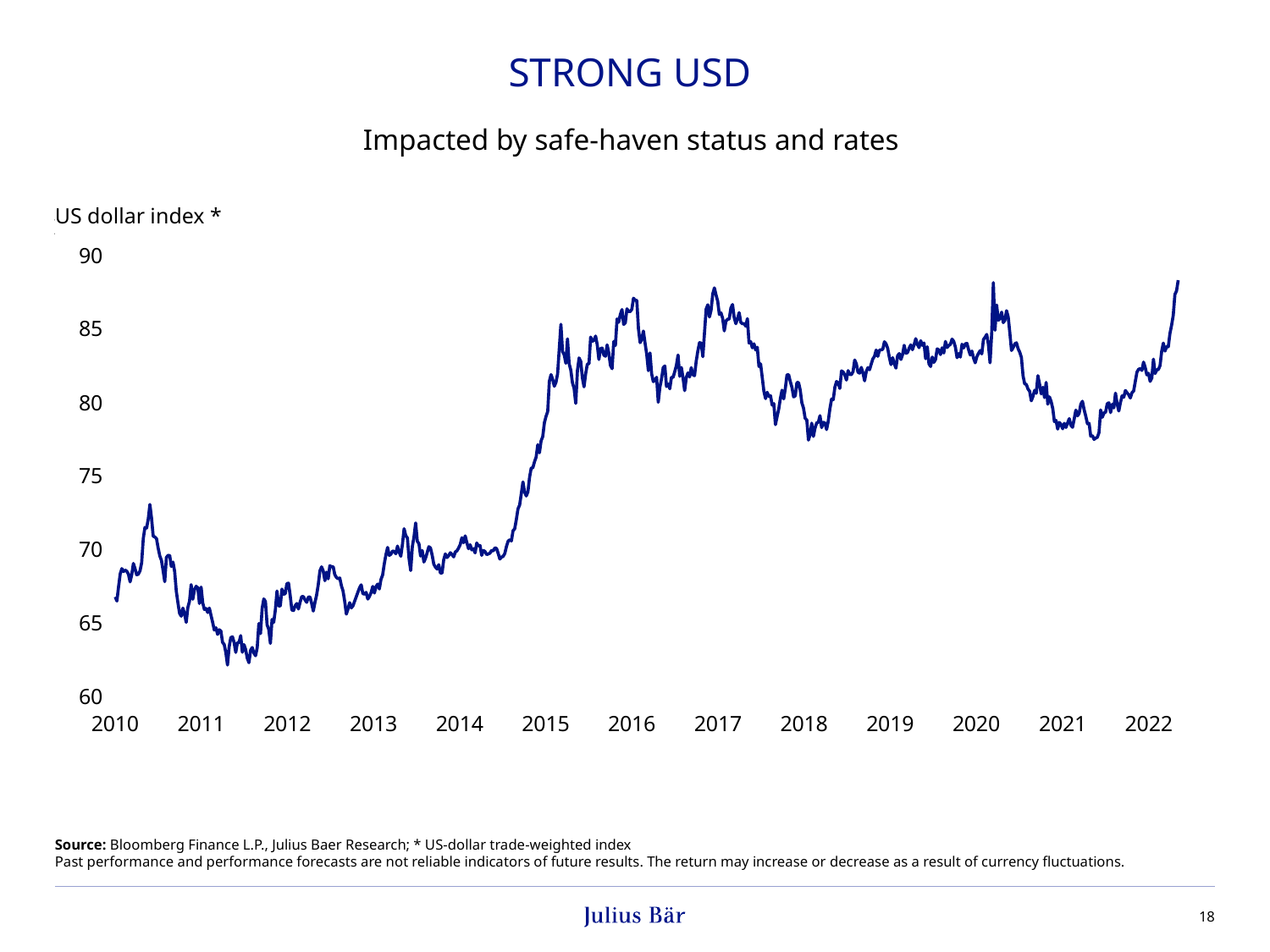
What label is given to the plotted series above the chart? US dollar index * Is the value of the US dollar index at the end of the series in 2022 greater or less than 85? greater What is the title of the slide containing the chart? STRONG USD Is the value of the US dollar index at the start of 2019 greater or less than 80? greater Does the US dollar index rise or fall between the start of 2014 and the start of 2016? rise What kind of chart is shown on the slide? line chart Does the US dollar index rise or fall between the start of 2017 and the start of 2018? fall How many series are plotted on the chart? 1 Is the lowest value of the US dollar index, reached in 2011, greater or less than 65? less In which year does the US dollar index reach its lowest point? 2011 How many year labels are shown on the x axis? 13